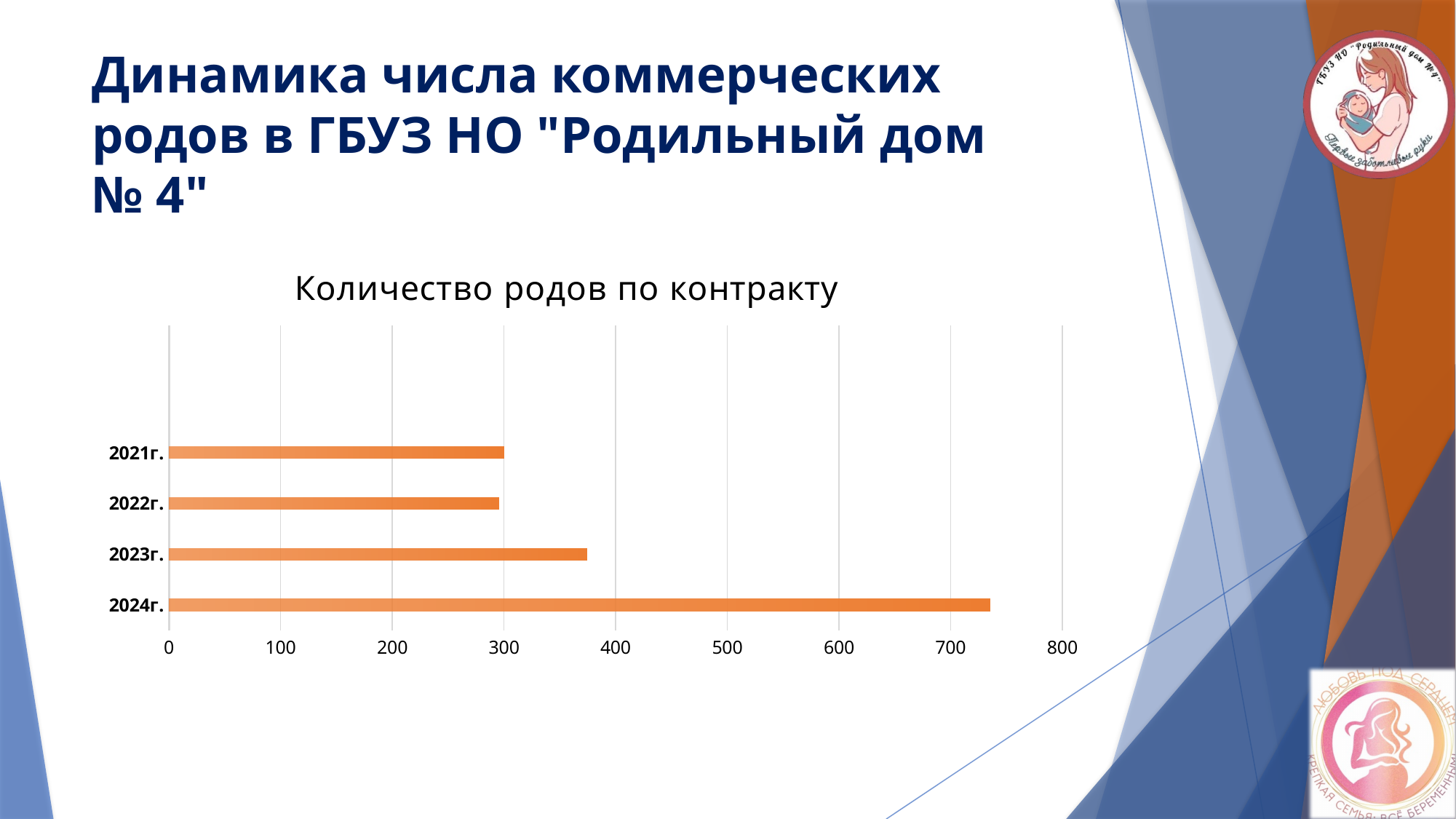
How many years (categories) are shown in the chart? 4 Is the value for 2023г. greater or less than 300? greater Which is larger, the value for 2023г. or the value for 2022г.? 2023г. What kind of chart is shown on the slide? bar chart Which year has the highest number of contract births? 2024г. Is the value for 2024г. greater or less than 800? less Is the value for 2023г. greater or less than 400? less What colour are the bars in the chart? orange Which is larger, the value for 2024г. or the value for 2021г.? 2024г. What is the title of the chart? Количество родов по контракту